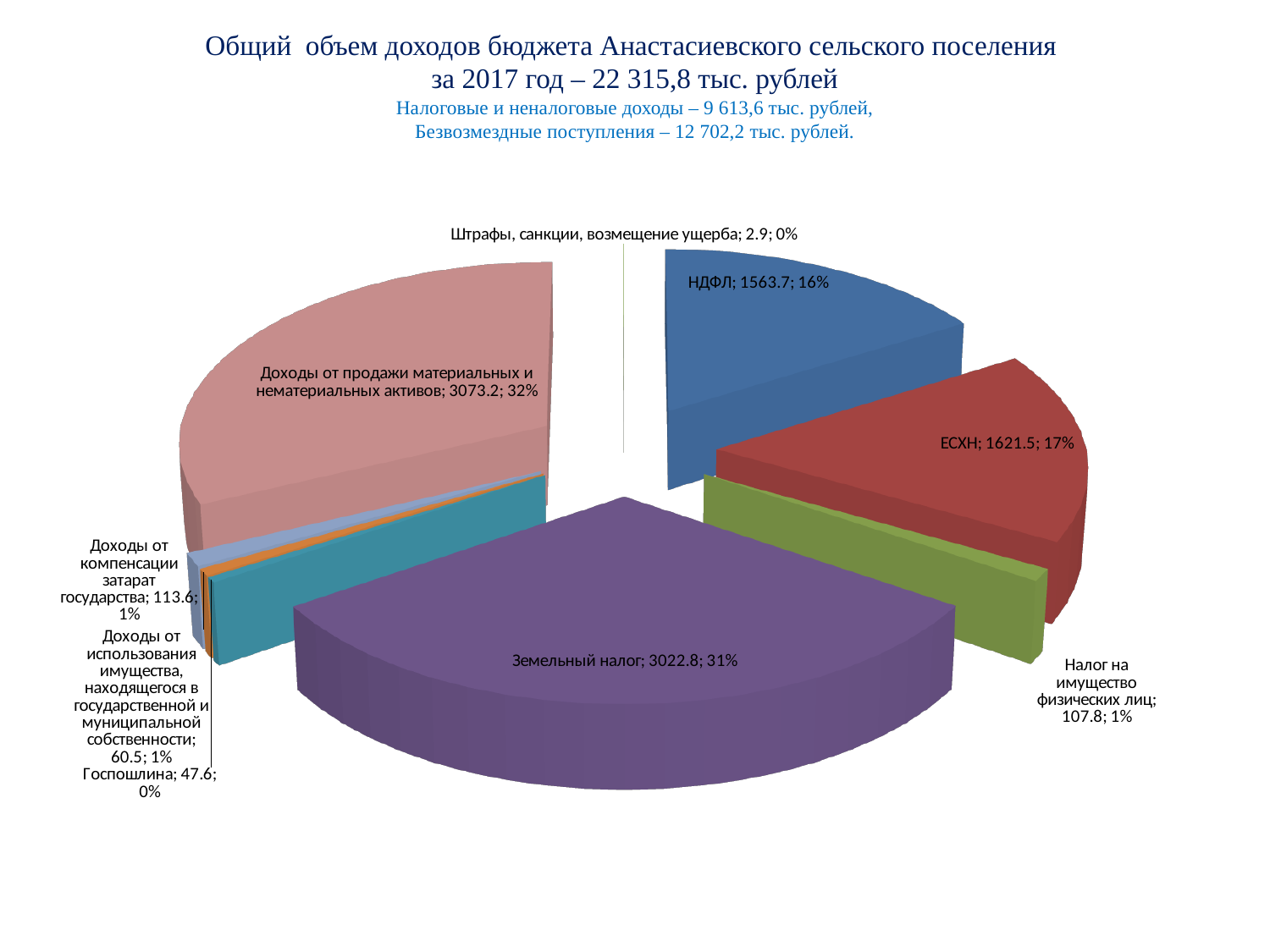
What share of the pie does Земельный налог represent? 31% What is the value for Земельный налог? 3022.8 How many categories are shown in the pie chart? 9 What is the difference between the values for ЕСХН and НДФЛ? 57.8 Which is larger, the value for ЕСХН or the value for НДФЛ? ЕСХН Which category has the smallest slice of the pie? Штрафы, санкции, возмещение ущерба Which category has the largest slice of the pie? Доходы от продажи материальных и нематериальных активов What type of chart is shown on the slide? Pie chart What is the value for НДФЛ? 1563.7 What is the value for Госпошлина? 47.6 What is the difference between the values for Земельный налог and Налог на имущество физических лиц? 2915 What is the value for Налог на имущество физических лиц? 107.8